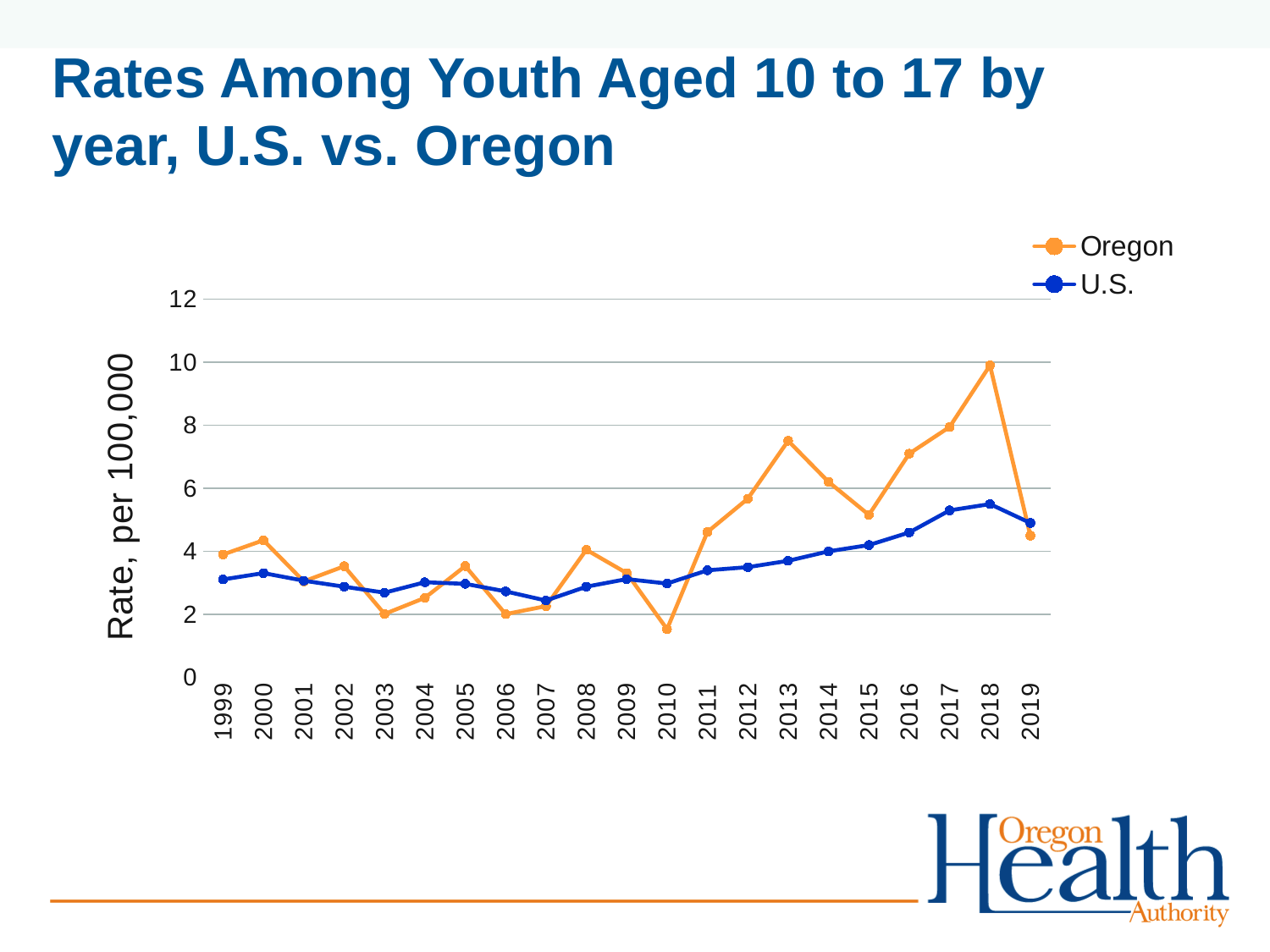
Is the Oregon value for 2010 greater or less than 2? less In which year does the Oregon series reach its lowest value? 2010 In 2013, which series has the larger value, Oregon or U.S.? Oregon How many years are plotted along the x axis? 21 Does the U.S. series rise or fall from 2010 to 2018? rise In 2010, which series has the larger value, Oregon or U.S.? U.S. Is the Oregon value for 2013 greater or less than 6? greater How many series does the legend list? 2 In which year does the Oregon series reach its highest value? 2018 Is the Oregon value for 2018 greater or less than 8? greater What kind of chart is shown on the slide? line chart